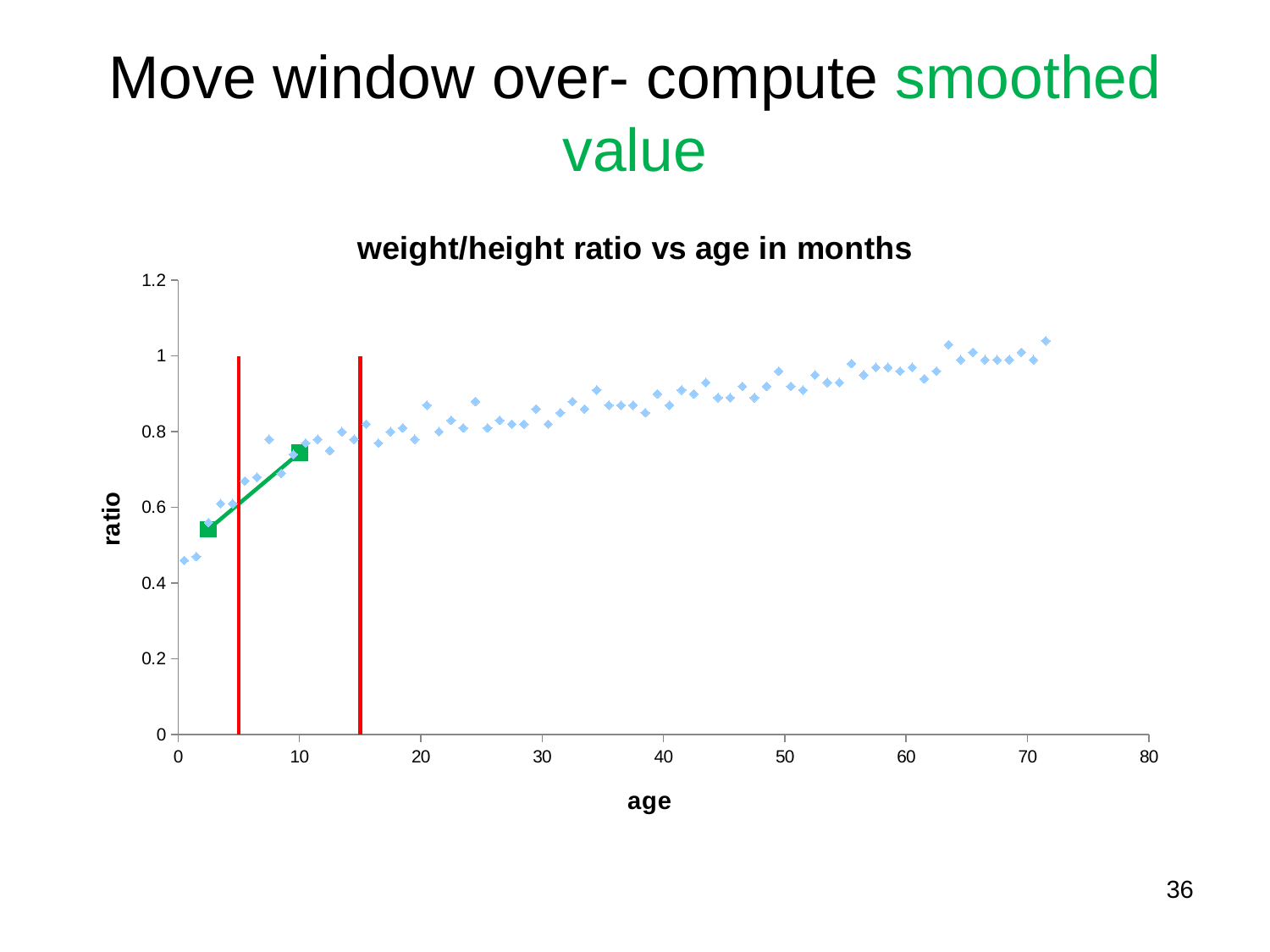
Is the ratio value at age 20 greater or less than 1? less At which age values on the x axis are the two red vertical lines placed? 5 and 15 What kind of chart is shown on the slide? scatter chart What is the label of the vertical axis of the chart? ratio What is the title of the chart? weight/height ratio vs age in months How many red vertical lines are drawn on the chart? 2 Is the ratio value at age 1 greater or less than 0.6? less What is the maximum value shown on the vertical axis of the chart? 1.2 Do the ratio values generally rise or fall as age increases along the x axis? rise Is the ratio value at age 30 greater or less than 0.8? greater